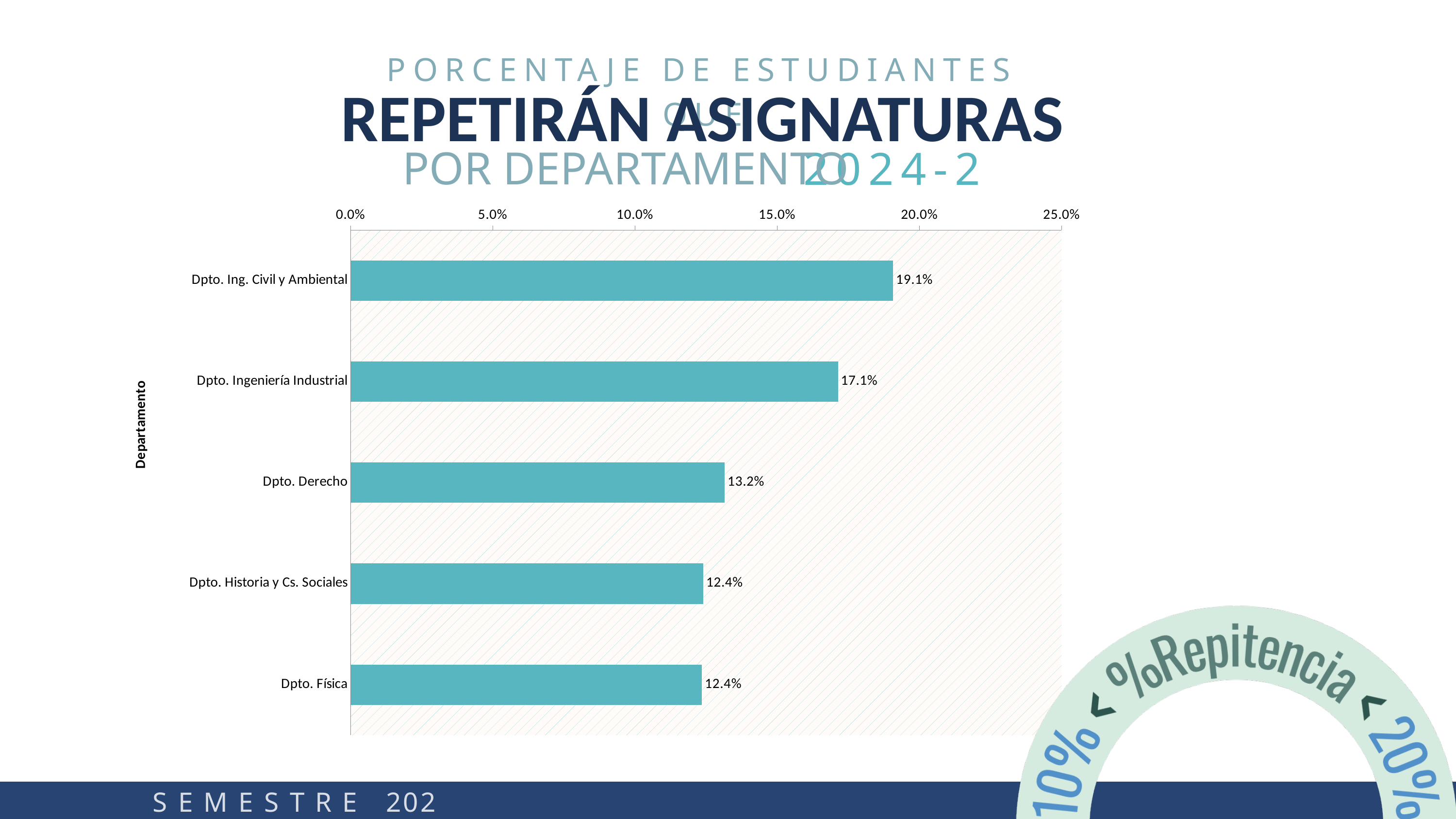
What is the highest tick value shown on the horizontal axis? 25.0% Is the value for Dpto. Ingeniería Industrial greater or less than 15.0%? greater What is the value for Dpto. Ing. Civil y Ambiental? 19.1% What is the value for Dpto. Ingeniería Industrial? 17.1% What is the value for Dpto. Derecho? 13.2% Which department has the highest percentage? Dpto. Ing. Civil y Ambiental Which is larger, the value for Dpto. Derecho or the value for Dpto. Física? Dpto. Derecho What kind of chart is shown on the slide? bar chart What is the value for Dpto. Historia y Cs. Sociales? 12.4% What is the label of the vertical axis? Departamento What is the difference between Dpto. Ing. Civil y Ambiental and Dpto. Ingeniería Industrial? 2.0% How many departments are shown in the chart? 5